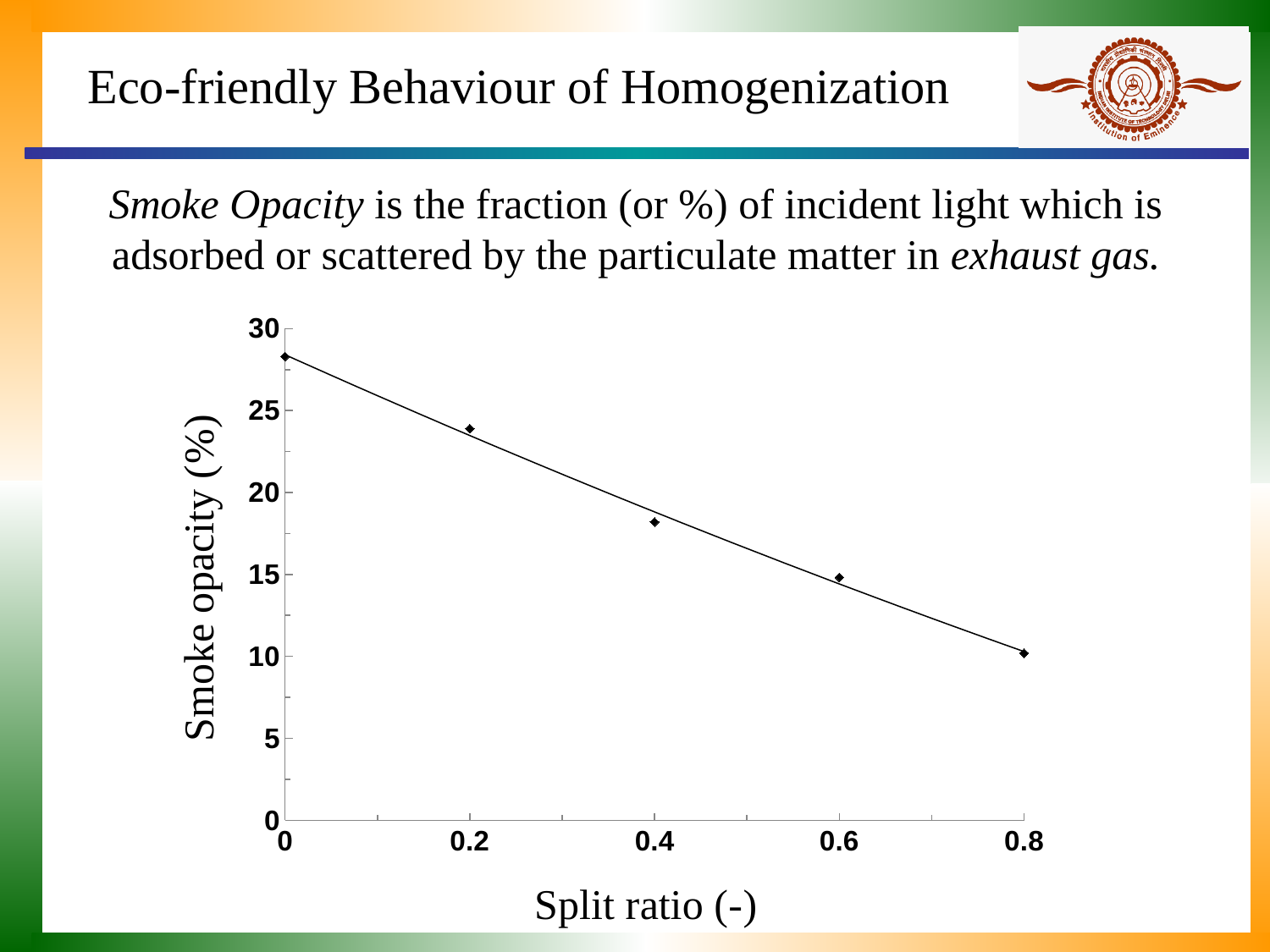
Which has the higher smoke opacity: split ratio 0.2 or split ratio 0.6? split ratio 0.2 Is the smoke opacity at split ratio 0.8 greater or less than 15? less At which split ratio is smoke opacity highest? 0 Is the smoke opacity at split ratio 0.4 greater or less than 20? less How many data points are plotted on the chart? 5 Is the smoke opacity at split ratio 0 greater or less than 25? greater Does smoke opacity rise or fall as the split ratio increases? fall What is the label of the vertical axis? Smoke opacity (%) At which split ratio is smoke opacity lowest? 0.8 What kind of chart is shown on the slide? scatter chart with a trend line What is the label of the horizontal axis? Split ratio (-)